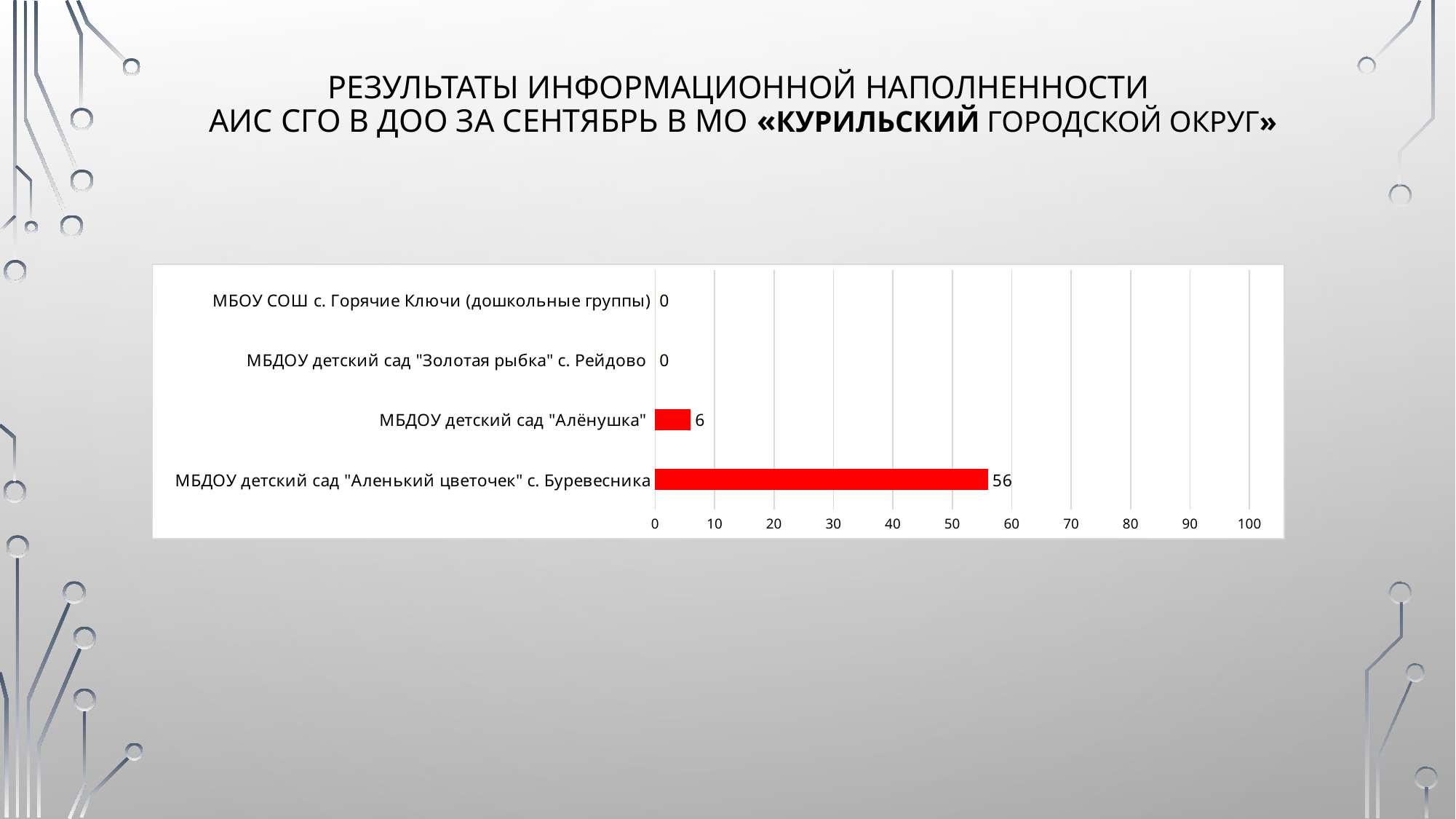
What is the maximum value shown on the horizontal axis? 100 What is the value for МБДОУ детский сад "Алёнушка"? 6 Is the value for МБДОУ детский сад "Аленький цветочек" с. Буревесника greater or less than 50? greater How many categories are shown in the chart? 4 What is the value for МБДОУ детский сад "Золотая рыбка" с. Рейдово? 0 What is the difference between the values for МБДОУ детский сад "Аленький цветочек" с. Буревесника and МБДОУ детский сад "Алёнушка"? 50 Which is larger, the value for МБДОУ детский сад "Алёнушка" or the value for МБДОУ детский сад "Золотая рыбка" с. Рейдово? МБДОУ детский сад "Алёнушка" Is the value for МБДОУ детский сад "Алёнушка" greater or less than 10? less Which category has the highest value? МБДОУ детский сад "Аленький цветочек" с. Буревесника What is the value for МБДОУ детский сад "Аленький цветочек" с. Буревесника? 56 What kind of chart is shown on the slide? bar chart What is the value for МБОУ СОШ с. Горячие Ключи (дошкольные группы)? 0